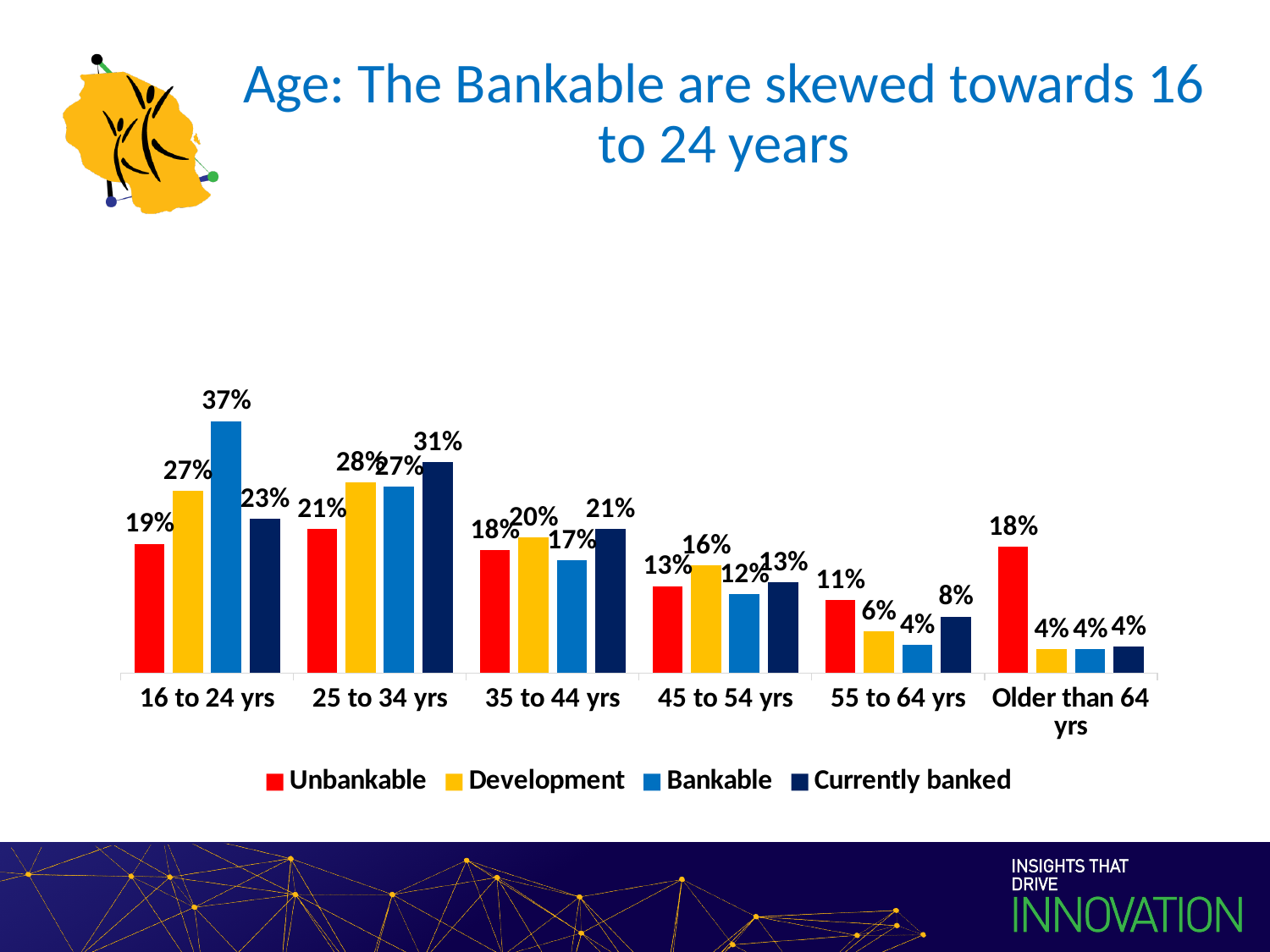
Does the Development series rise or fall from the 25 to 34 yrs group to the Older than 64 yrs group? Fall What is the difference between the Bankable and Unbankable values for the 16 to 24 yrs age group? 18% What is the Currently banked value for the 25 to 34 yrs age group? 31% What is the Unbankable value for the Older than 64 yrs age group? 18% What kind of chart is shown on the slide? Bar chart How many age groups are shown on the x axis? 6 How many series does the legend list? 4 What is the Bankable value for the 16 to 24 yrs age group? 37% Which age group has the highest Bankable value? 16 to 24 yrs Which colour represents the Currently banked series in the legend? Dark navy blue Which is larger for the 55 to 64 yrs age group: the Unbankable value or the Currently banked value? Unbankable Which age group has the lowest Unbankable value? 55 to 64 yrs